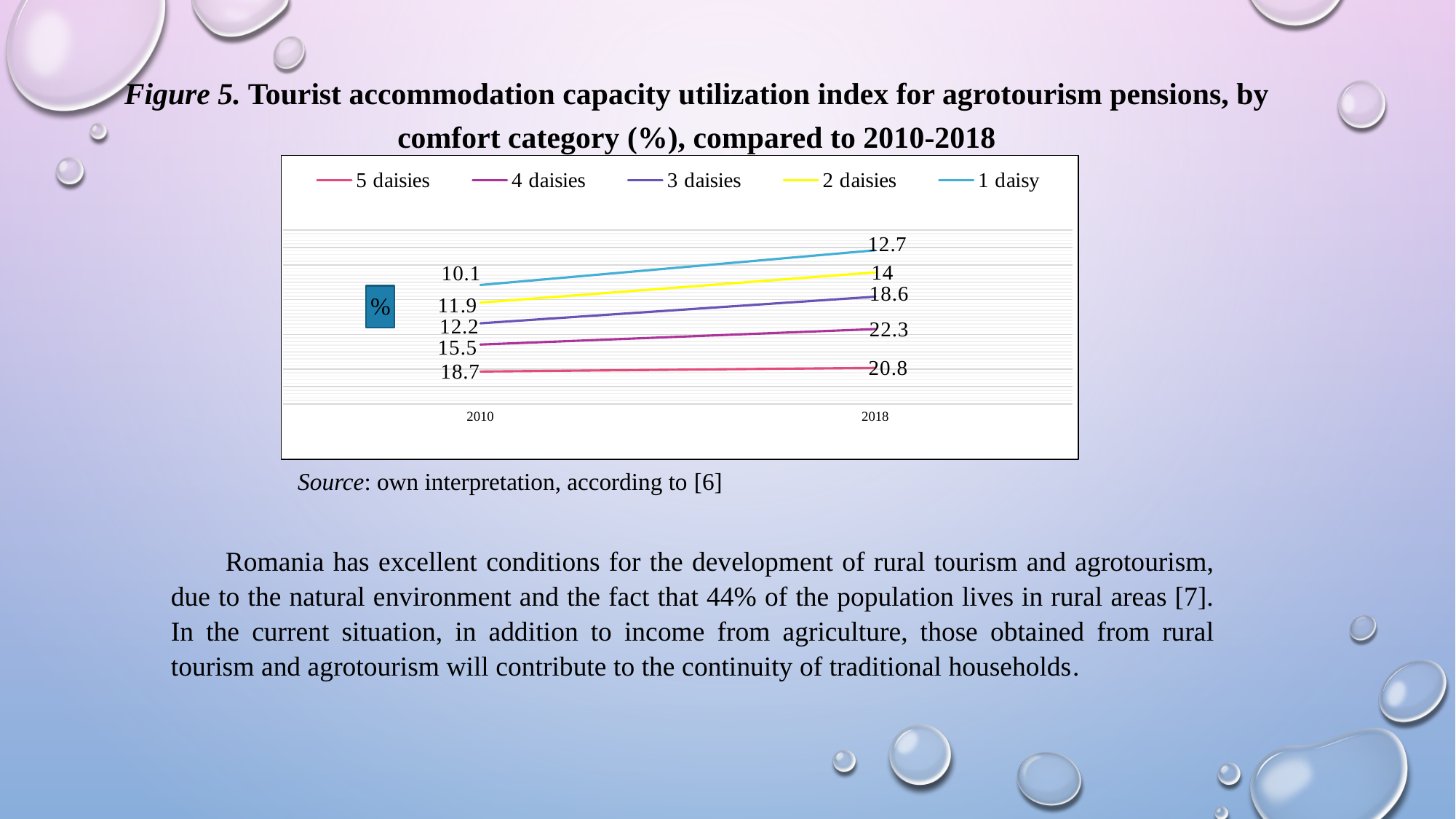
What is the value for 2 daisies in 2018? 14 How many series does the legend list? 5 How many years are shown on the x axis? 2 Does the value for 2 daisies rise or fall from 2010 to 2018? rise Which comfort category has the highest value in 2018? 4 daisies What type of chart is shown in Figure 5? line chart What is the value for 1 daisy in 2010? 10.1 By how much did the value for 3 daisies change from 2010 to 2018? 6.4 What is the value for 5 daisies in 2010? 18.7 Which is larger in 2018, the value for 5 daisies or the value for 3 daisies? 5 daisies What is the value for 4 daisies in 2018? 22.3 Which comfort category has the lowest value in 2010? 1 daisy